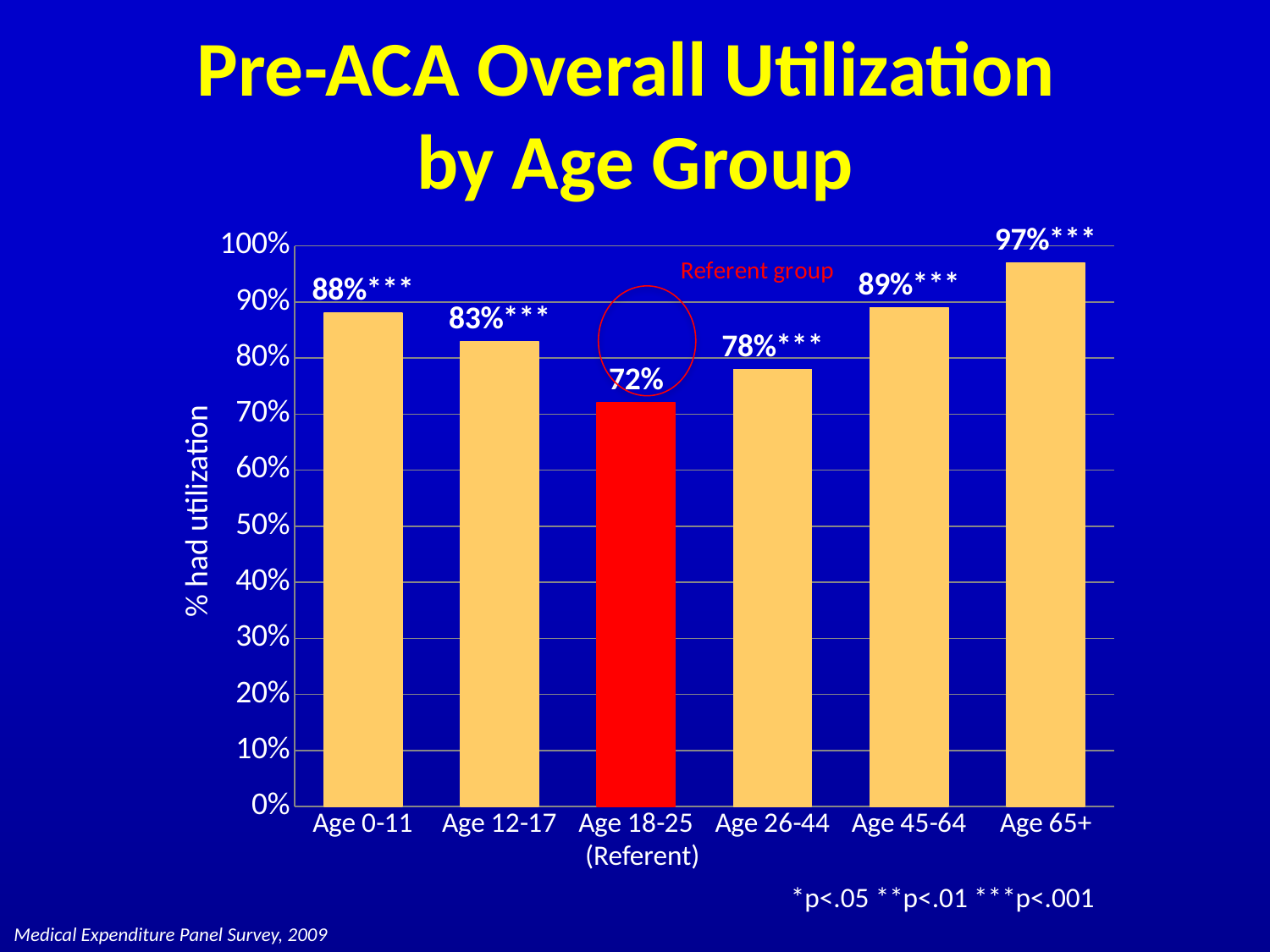
Which is larger, the value for Age 12-17 or the value for Age 26-44? Age 12-17 Which bar is coloured red? Age 18-25 (Referent) How many age groups are shown on the chart? 6 What is the value for Age 65+? 97% Is the value for Age 45-64 greater or less than 80%? greater What is the value for Age 18-25 (Referent)? 72% What is the title of the chart? Pre-ACA Overall Utilization by Age Group What kind of chart is shown on the slide? bar chart What is the difference between the values for Age 65+ and Age 18-25? 25% Which age group has the highest utilization? Age 65+ Which age group has the lowest utilization? Age 18-25 (Referent) What is the value for Age 0-11? 88%